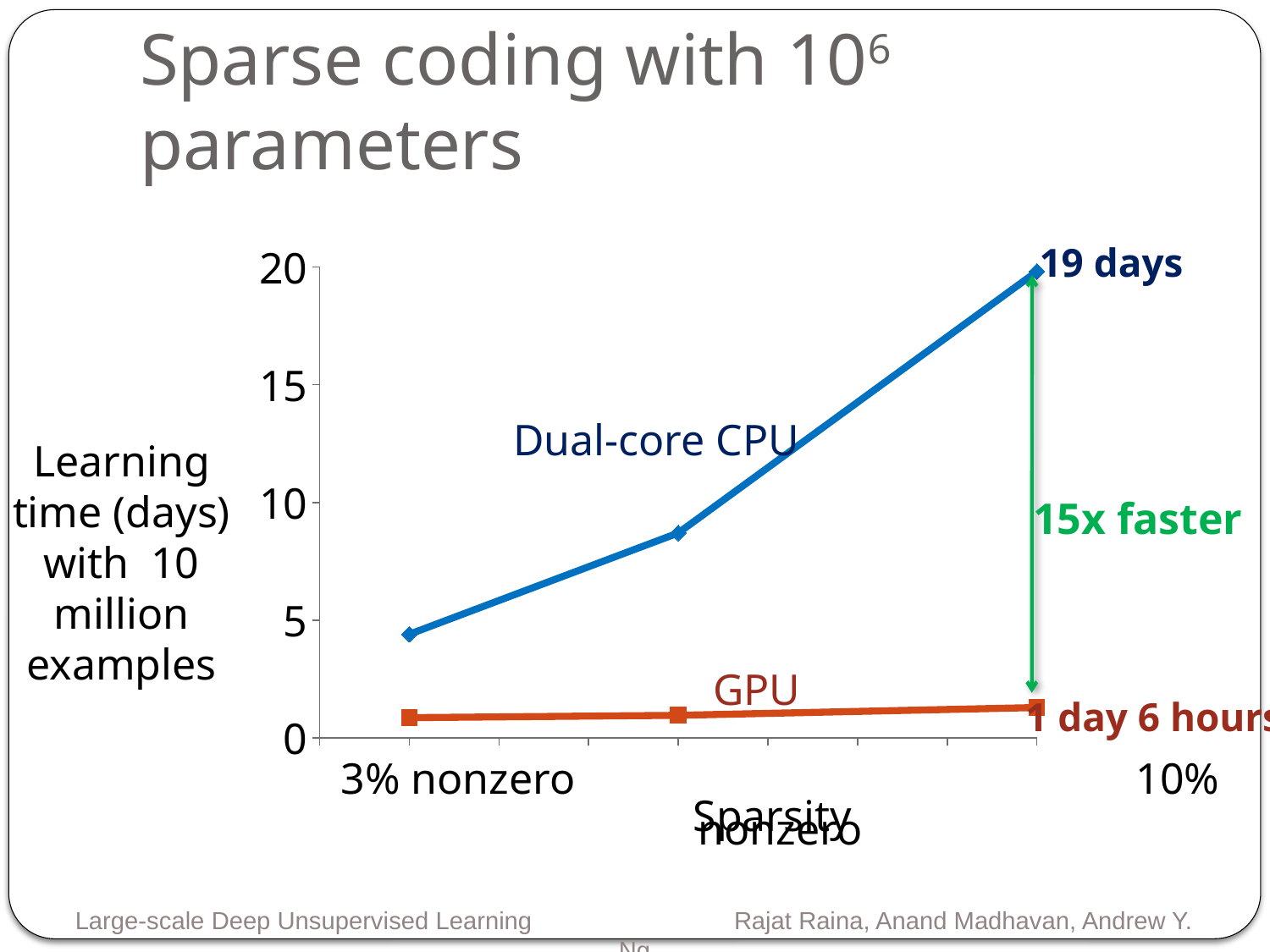
Is the Dual-core CPU learning time at the middle data point greater or less than 10 days? less At 10% nonzero, which has the larger learning time, the Dual-core CPU or the GPU? Dual-core CPU Which series reaches the highest learning time on the chart? Dual-core CPU What is the learning time for the Dual-core CPU at 10% nonzero? 19 days Does the Dual-core CPU learning time rise or fall as sparsity increases from 3% nonzero to 10% nonzero? rises What kind of chart is shown on the slide? line chart How many data points are plotted for each series? 3 What speedup does the green annotation on the chart state? 15x faster How many data series are plotted on the chart? 2 Is the Dual-core CPU learning time at 3% nonzero greater or less than 10 days? less Is the GPU learning time at 3% nonzero greater or less than 5 days? less What is the learning time for the GPU at 10% nonzero? 1 day 6 hours